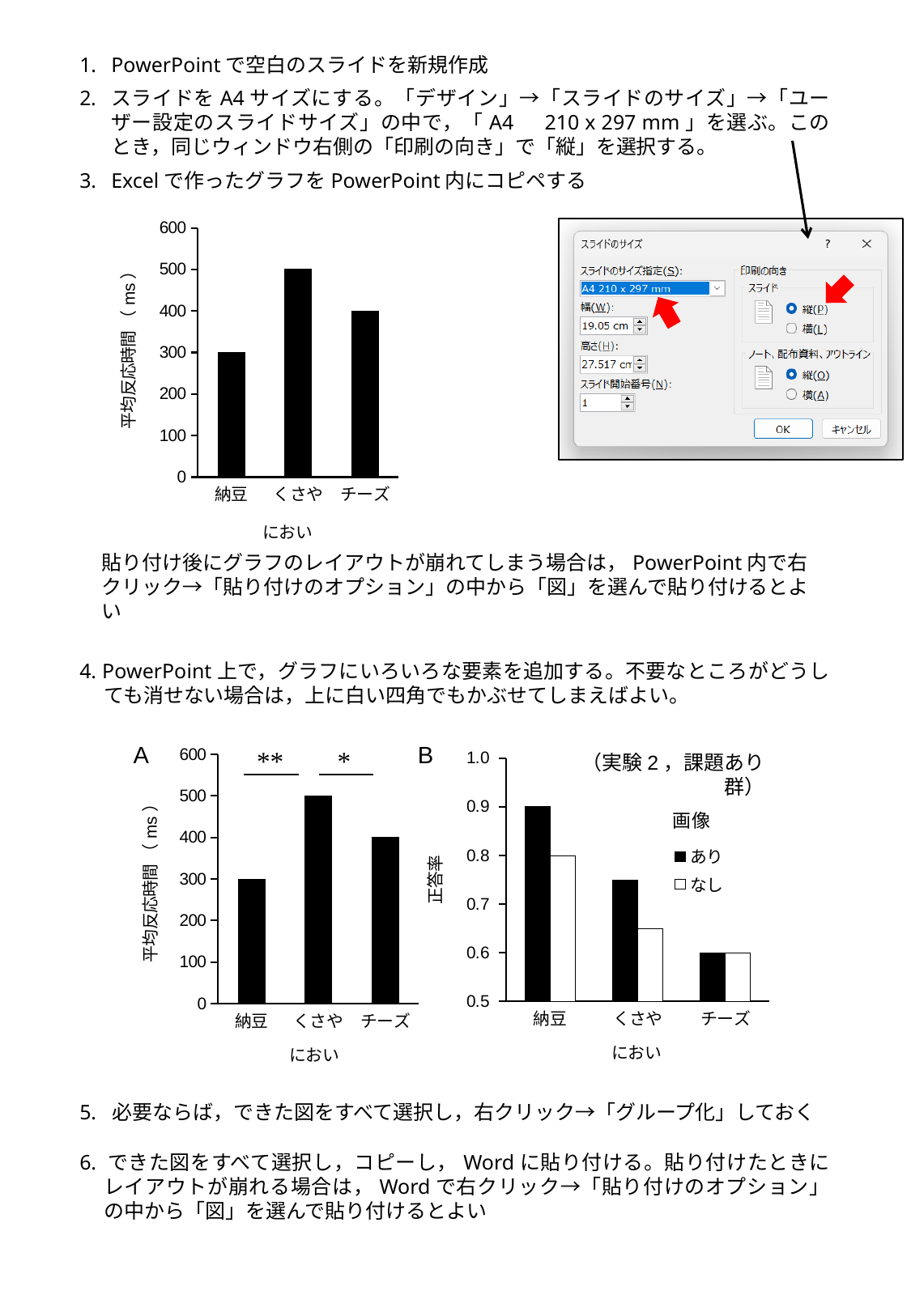
In chart B (正答率 by におい), do the values for the あり series rise or fall from 納豆 to チーズ? fall In the top chart (平均反応時間 by におい), what kind of chart is it? bar chart In the top chart (平均反応時間 by におい), how many categories are shown on the x axis? 3 In chart A (平均反応時間 by におい), what is the difference between the values for くさや and チーズ? 100 In chart B (正答率 by におい), how many series does the legend list? 2 In chart A (平均反応時間 by におい), what is the value for 納豆? 300 In chart B (正答率 by におい), is the value for くさや in the なし series greater or less than 0.7? less In the top chart (平均反応時間 by におい), what is the value for くさや? 500 In the top chart (平均反応時間 by におい), which category has the highest value? くさや In the top chart (平均反応時間 by におい), which category has the lowest value? 納豆 In chart B (正答率 by におい), what is the value for 納豆 in the あり series? 0.9 In chart A (平均反応時間 by におい), what is the label of the y axis? 平均反応時間（ms）